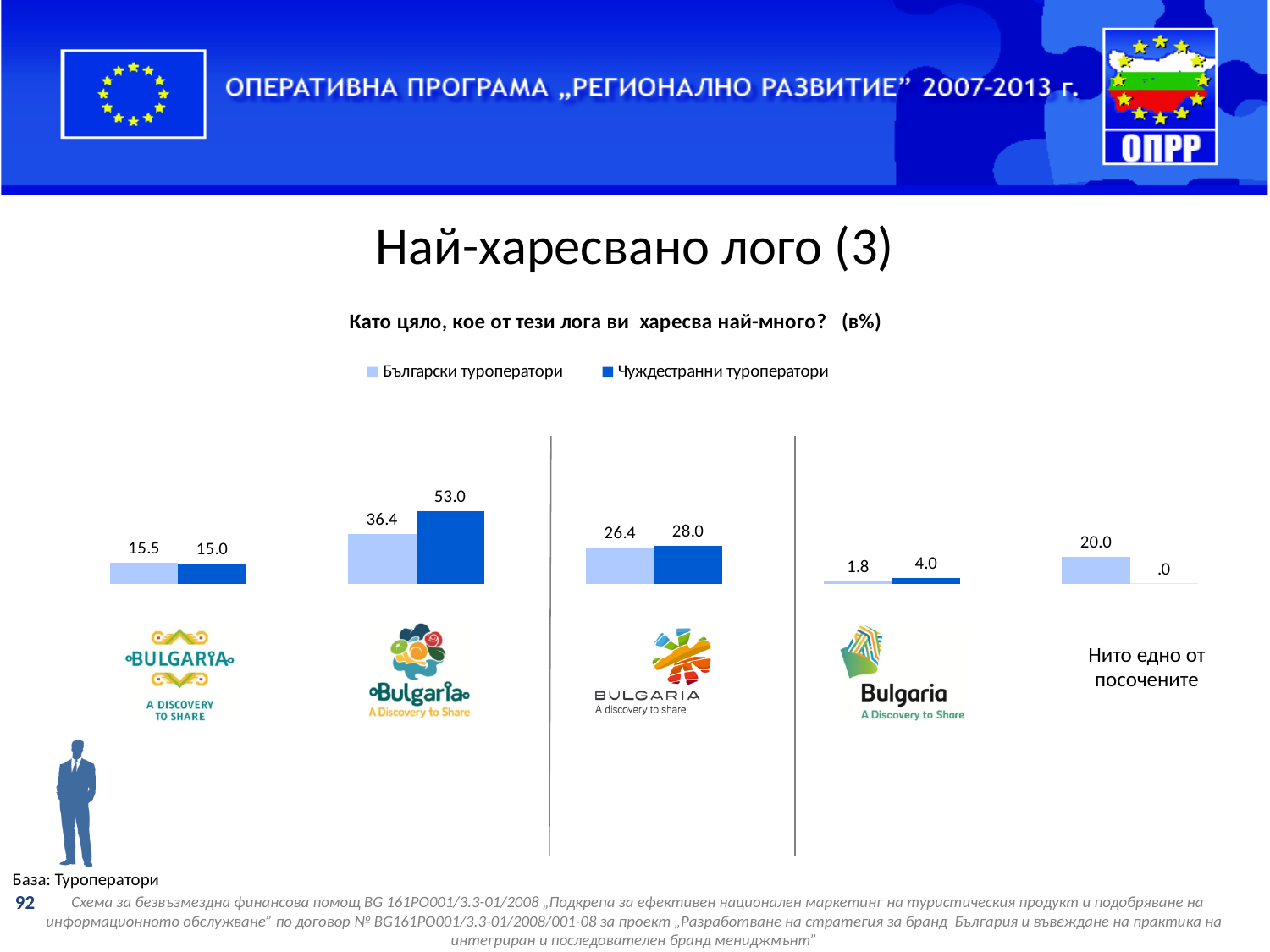
For the third logo from the left, which series has the larger value: Български туроператори or Чуждестранни туроператори? Чуждестранни туроператори What is the value for Български туроператори for the category 'Нито едно от посочените'? 20.0 What is the value for Чуждестранни туроператори for the second logo from the left? 53.0 How many categories (logo options) are shown in the chart? 5 Which category has the lowest value for Български туроператори? the fourth logo from the left What is the difference between the Чуждестранни туроператори and Български туроператори values for the second logo from the left? 16.6 What is the value for Чуждестранни туроператори for the category 'Нито едно от посочените'? .0 Which category has the highest value for Чуждестранни туроператори? the second logo from the left What type of chart is shown on the slide? bar chart How many series does the chart legend list? 2 What is the value for Български туроператори for the second logo from the left? 36.4 What is the question text shown as the chart title? Като цяло, кое от тези лога ви харесва най-много? (в%)